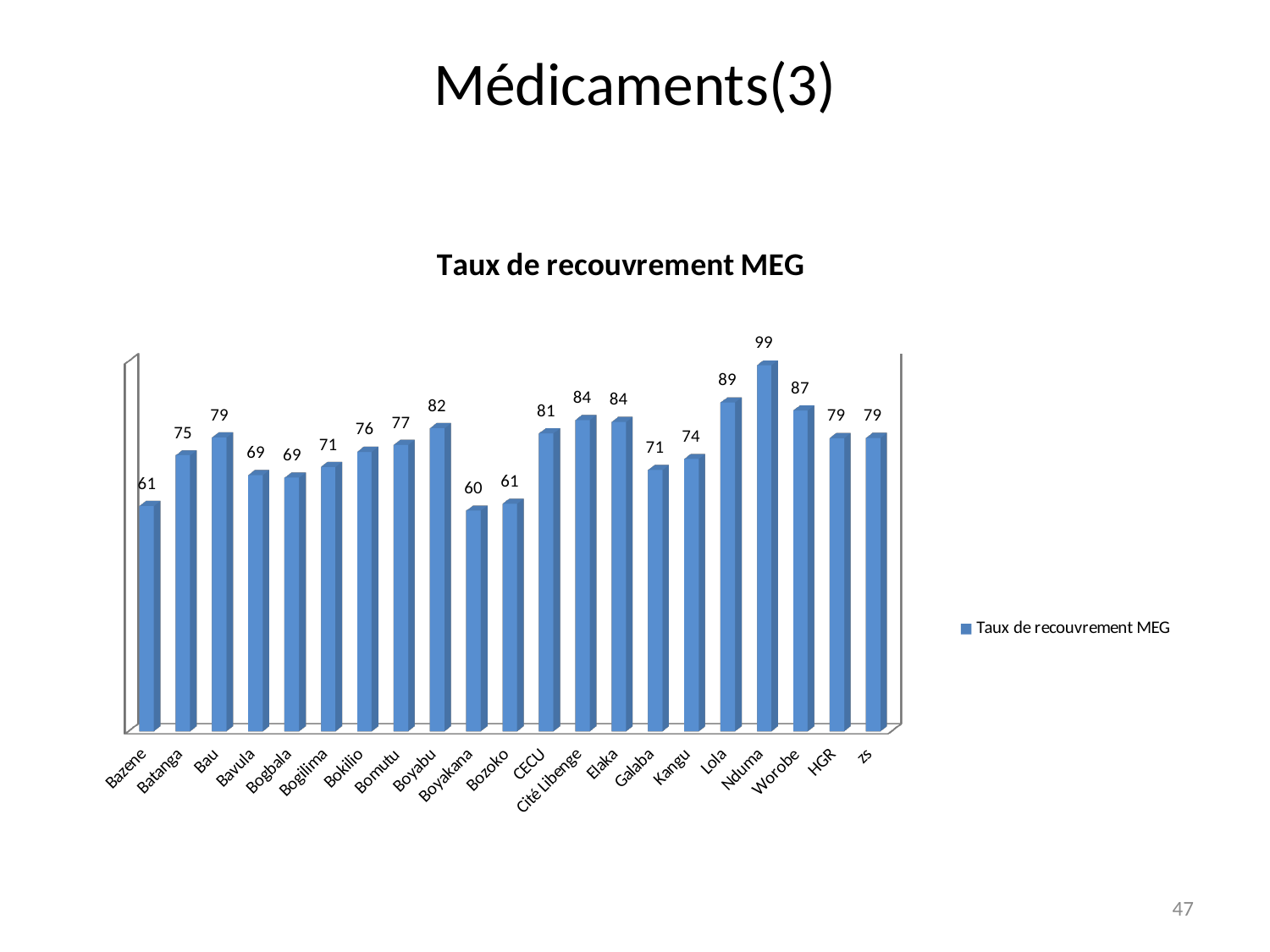
What is the title of the chart? Taux de recouvrement MEG What is the difference between the values for Nduma and Boyakana? 39 Which category has the lowest value? Boyakana Which is larger, the value for Worobe or the value for Bau? Worobe Which category has the highest value? Nduma What is the value for Boyabu? 82 What kind of chart is shown? Bar chart What is the value for Cité Libenge? 84 What is the difference between the values for Lola and Kangu? 15 What is the value for Nduma? 99 How many series does the legend list? 1 How many categories are shown on the x axis? 21